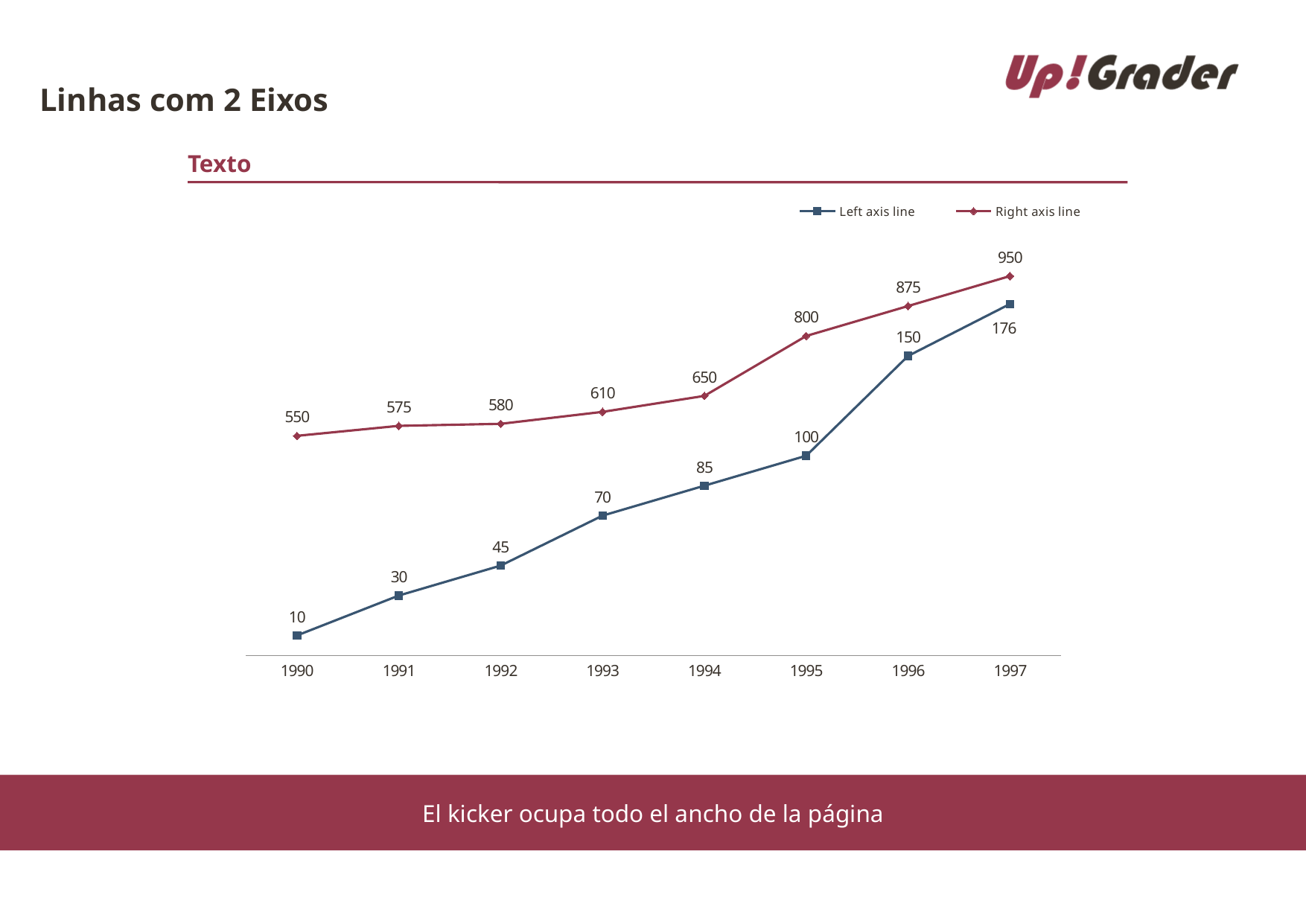
What is the value of the Right axis line in 1993? 610 In which year is the Right axis line highest? 1997 In which year is the Left axis line lowest? 1990 Does the Left axis line rise or fall from 1990 to 1997? Rise How many series does the legend list? 2 What is the value of the Left axis line in 1997? 176 What kind of chart is shown on the slide? Line chart What is the value of the Left axis line in 1995? 100 What is the difference between the Right axis line values in 1997 and 1996? 75 Which is larger for the Right axis line: the value in 1991 or the value in 1992? 1992 How many years are shown on the x axis? 8 What is the difference between the Left axis line values in 1996 and 1995? 50